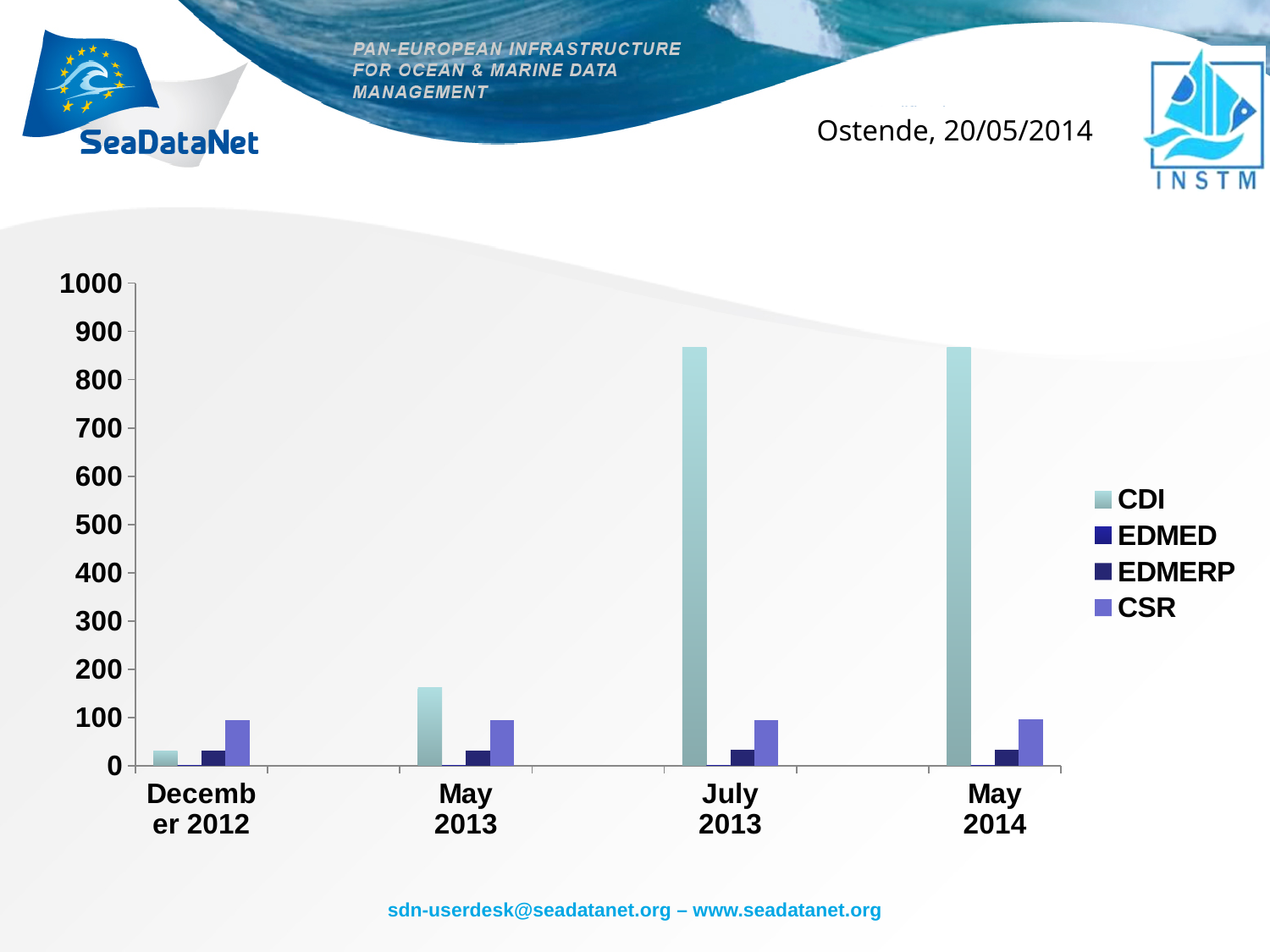
Is the value for CDI in December 2012 greater or less than 100? less Which is larger in December 2012, CSR or CDI? CSR How many categories are shown on the x axis? 4 Is the value for CDI in July 2013 greater or less than 800? greater Does the CDI series rise or fall from December 2012 to July 2013? rise Which series has the lowest value in July 2013? EDMED Which series has the highest value in May 2014? CDI What kind of chart is shown on the slide? bar chart Is the value for CSR in May 2014 greater or less than 200? less How many series does the legend list? 4 Which series are listed in the legend? CDI, EDMED, EDMERP, CSR